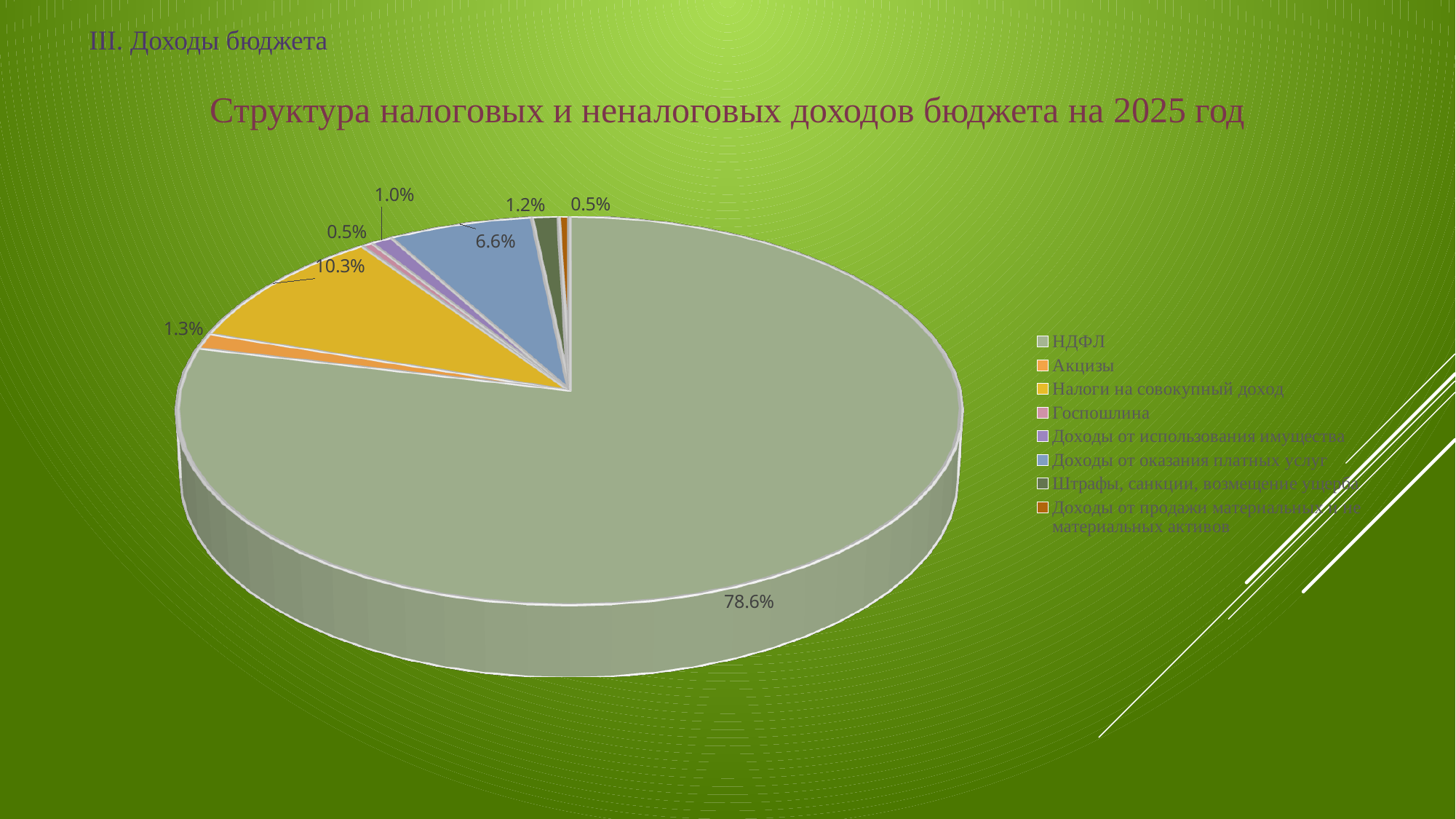
What is the title of the chart? Структура налоговых и неналоговых доходов бюджета на 2025 год What is the value shown for Штрафы, санкции, возмещение ущерба? 1.2% What is the value shown for Доходы от оказания платных услуг? 6.6% Which category has the largest slice of the pie? НДФЛ What is the value shown for Налоги на совокупный доход? 10.3% What is the difference between the shares of Налоги на совокупный доход and Доходы от оказания платных услуг? 3.7% What type of chart is shown on the slide? Pie chart What share of the pie does НДФЛ account for? 78.6% What is the value shown for Доходы от использования имущества? 1.0% Which is larger: Налоги на совокупный доход or Доходы от оказания платных услуг? Налоги на совокупный доход What is the value shown for Акцизы? 1.3% How many categories does the legend list? 8